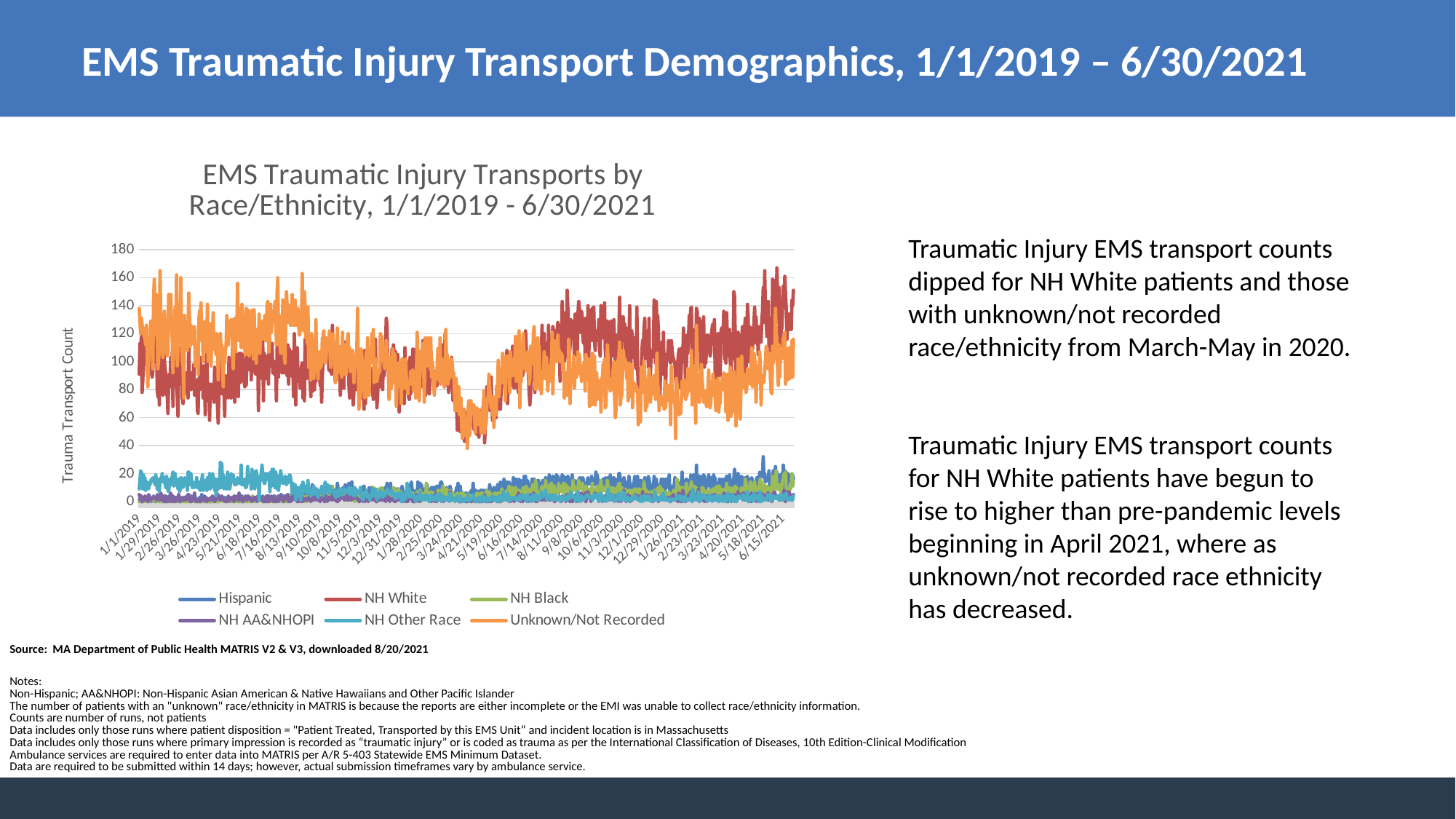
Do the values for Unknown/Not Recorded rise or fall from early 2019 to mid-2021? fall What is the label on the vertical axis of the chart? Trauma Transport Count What kind of chart is shown on the slide? Line chart Which series has the highest values during the first half of 2019? Unknown/Not Recorded In the first half of 2019, which series is higher: NH White or Unknown/Not Recorded? Unknown/Not Recorded How many series does the legend of the chart list? 6 Do the values for NH White rise or fall from mid-2020 to mid-2021? rise How many series in the chart have values above 40 at any point? 2 Is the value for NH White in June 2021 greater or less than 100? greater In May-June 2021, which series is higher: NH White or Unknown/Not Recorded? NH White Is the value for NH AA&NHOPI throughout the period greater or less than 40? less What is the title of the chart? EMS Traumatic Injury Transports by Race/Ethnicity, 1/1/2019 - 6/30/2021